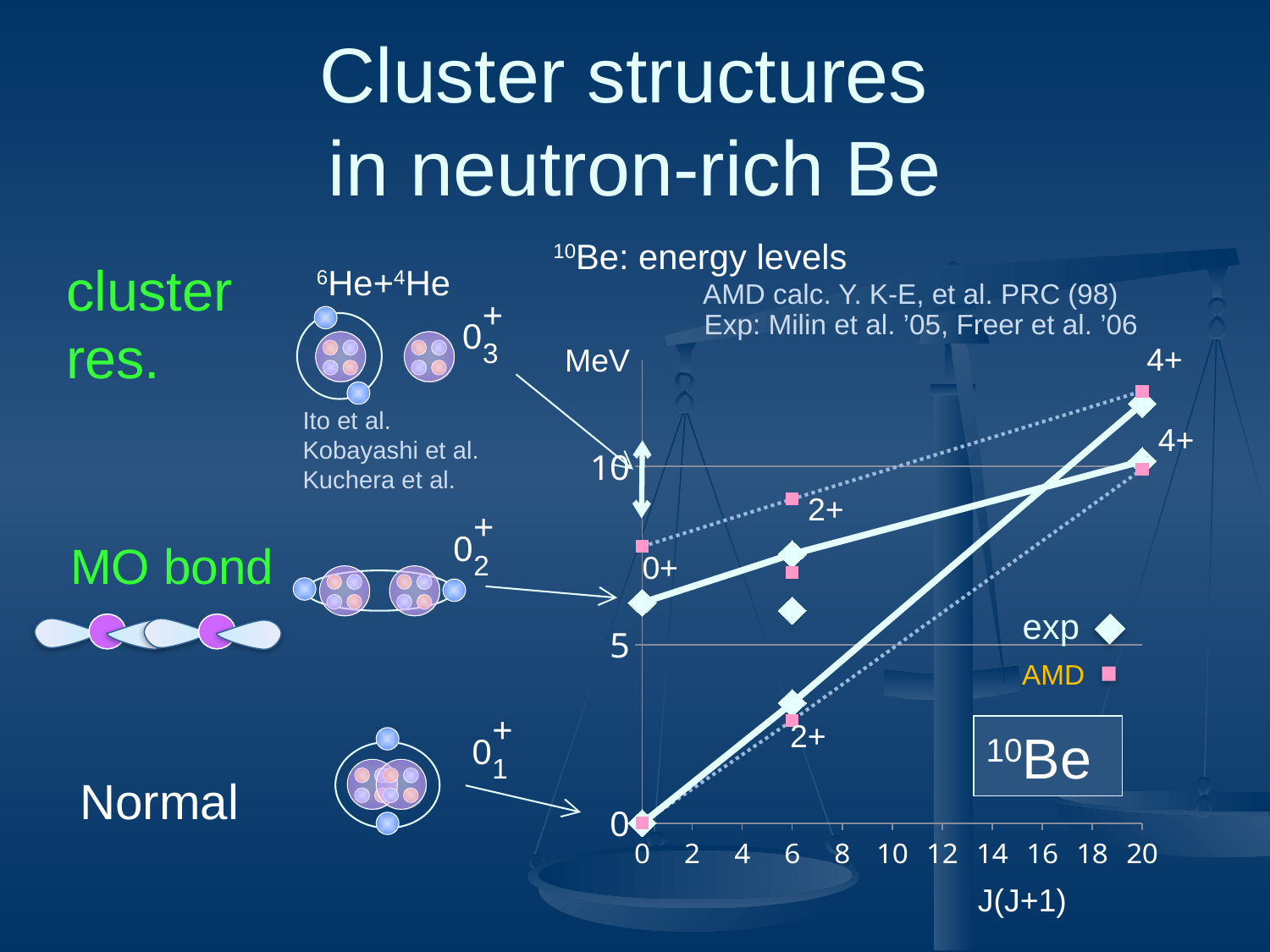
What is the exp energy of the 0+ ground state at J(J+1) = 0 in the 10Be chart? 0 Is the exp value for the upper 4+ state at J(J+1) = 20 greater or less than 10 MeV? greater Is the exp value for the lower 2+ state at J(J+1) = 6 greater or less than 5 MeV? less What is the label of the x axis of the 10Be energy levels chart? J(J+1) Do the exp energies of the ground-state band rise or fall as J(J+1) increases? rise What is the highest tick value shown on the x axis of the 10Be energy levels chart? 20 Is the exp value for the 0+ state of the MO bond band at J(J+1) = 0 greater or less than 5 MeV? greater What kind of chart is used to show the 10Be energy levels? scatter chart with lines How many series does the legend of the 10Be energy levels chart list? 2 What are the two series named in the legend of the 10Be energy levels chart? exp and AMD What is the unit shown on the y axis of the 10Be energy levels chart? MeV